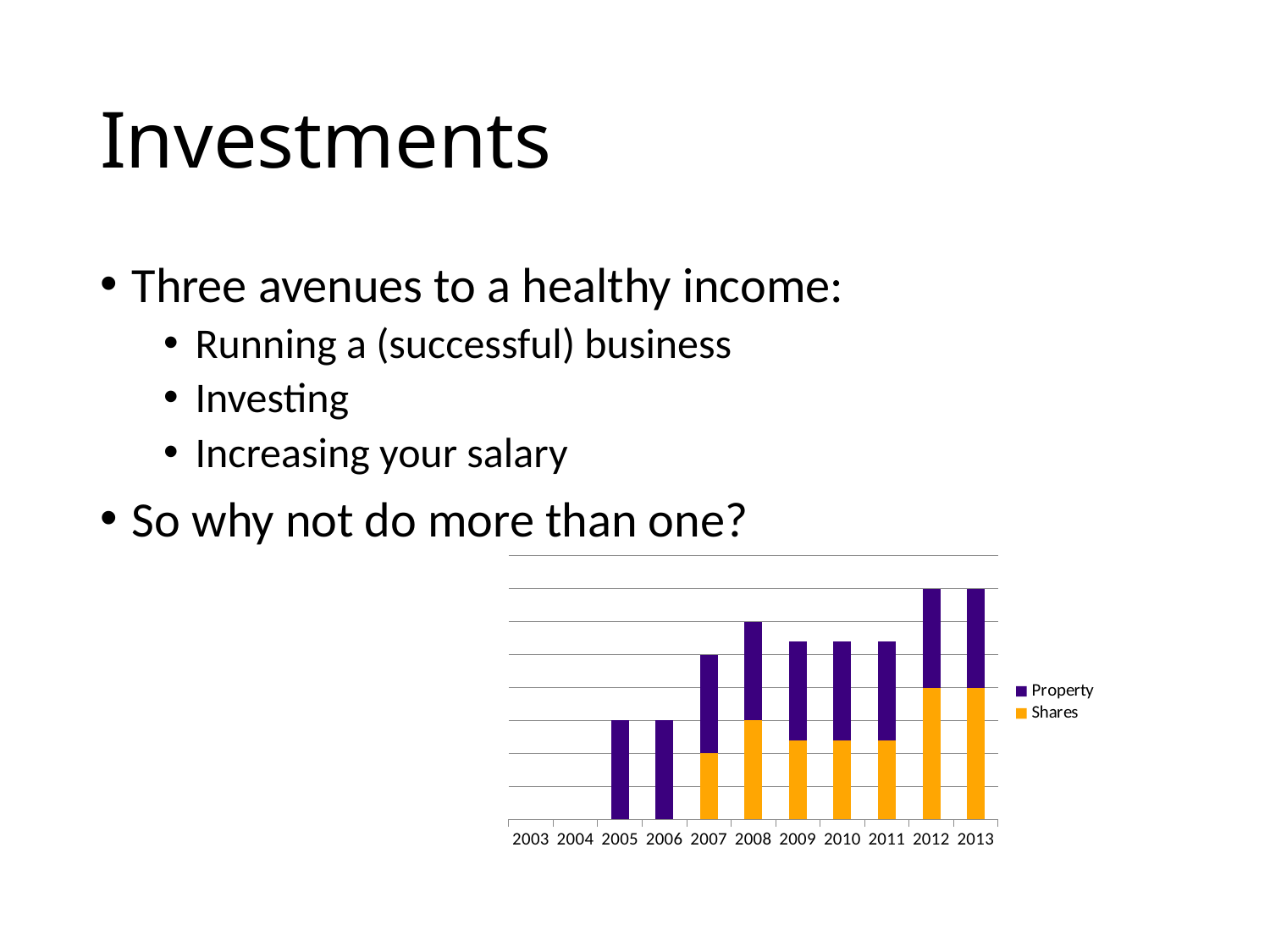
How many series does the chart's legend list? 2 What kind of chart is shown on the slide? Stacked bar chart In which year does the Shares series first appear in the chart? 2007 Which is larger, the total bar for 2005 or the total bar for 2009? 2009 How many years are labelled on the x axis of the chart? 11 What are the two series named in the chart's legend? Property and Shares Do the total bar heights generally rise or fall from 2005 to 2013? Rise Which is larger, the total bar for 2012 or the total bar for 2011? 2012 Which colour represents Shares in the chart? Orange Which is larger, the Shares value for 2012 or the Shares value for 2008? 2012 How many years on the x axis have a visible bar? 9